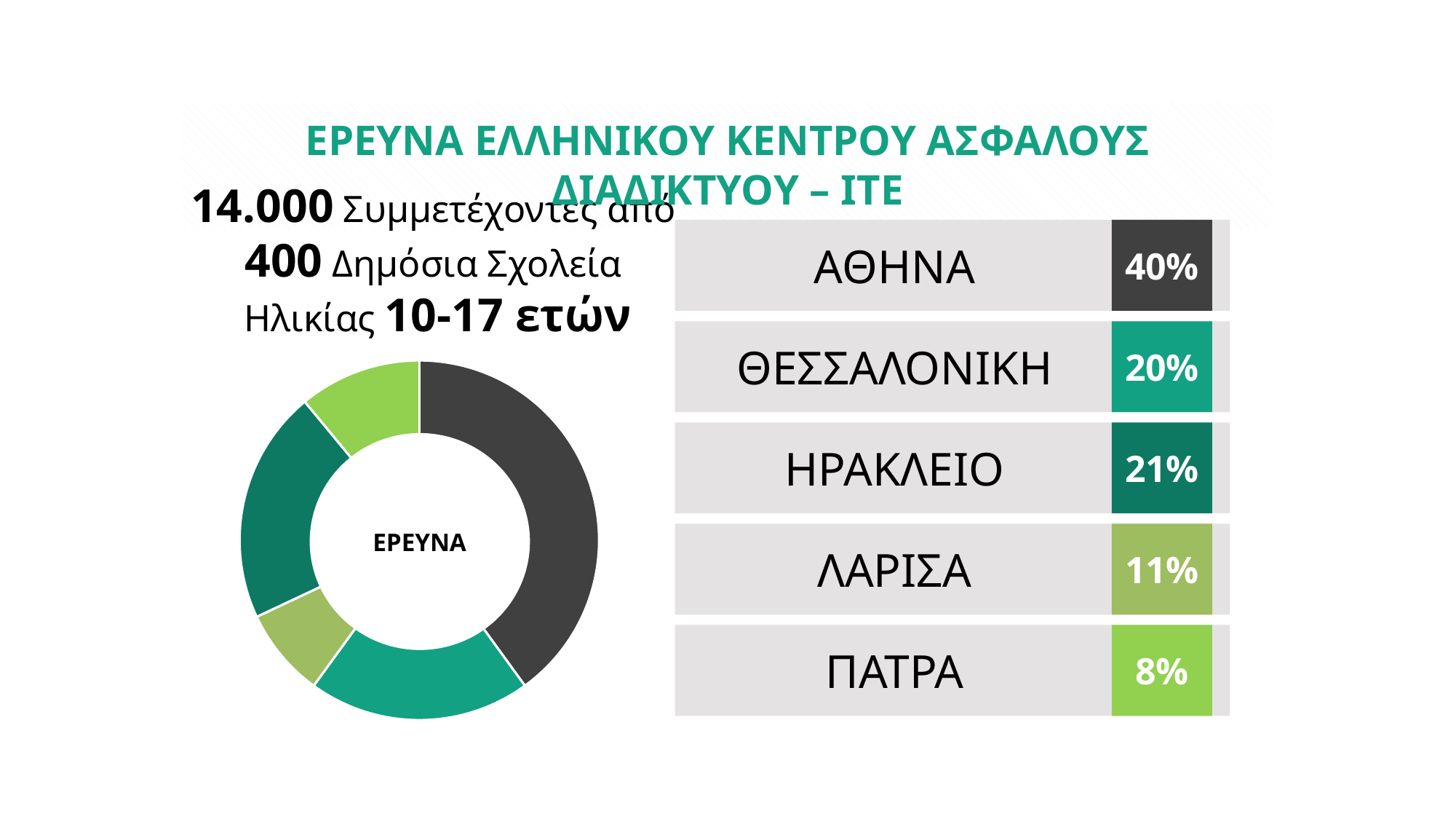
Which city has the largest share in the chart? ΑΘΗΝΑ What is the difference in percentage points between ΑΘΗΝΑ and ΘΕΣΣΑΛΟΝΙΚΗ? 20 How many cities are shown in the chart? 5 What percentage is shown for ΠΑΤΡΑ? 8% What percentage is shown for ΘΕΣΣΑΛΟΝΙΚΗ? 20% What percentage is shown for ΗΡΑΚΛΕΙΟ? 21% What kind of chart is shown on the slide? Doughnut chart Which city has the smallest share in the chart? ΠΑΤΡΑ What is the combined share of ΛΑΡΙΣΑ and ΠΑΤΡΑ? 19% Which has a larger share, ΗΡΑΚΛΕΙΟ or ΘΕΣΣΑΛΟΝΙΚΗ? ΗΡΑΚΛΕΙΟ What percentage is shown for ΑΘΗΝΑ? 40% What word is written in the centre of the doughnut chart? ΕΡΕΥΝΑ